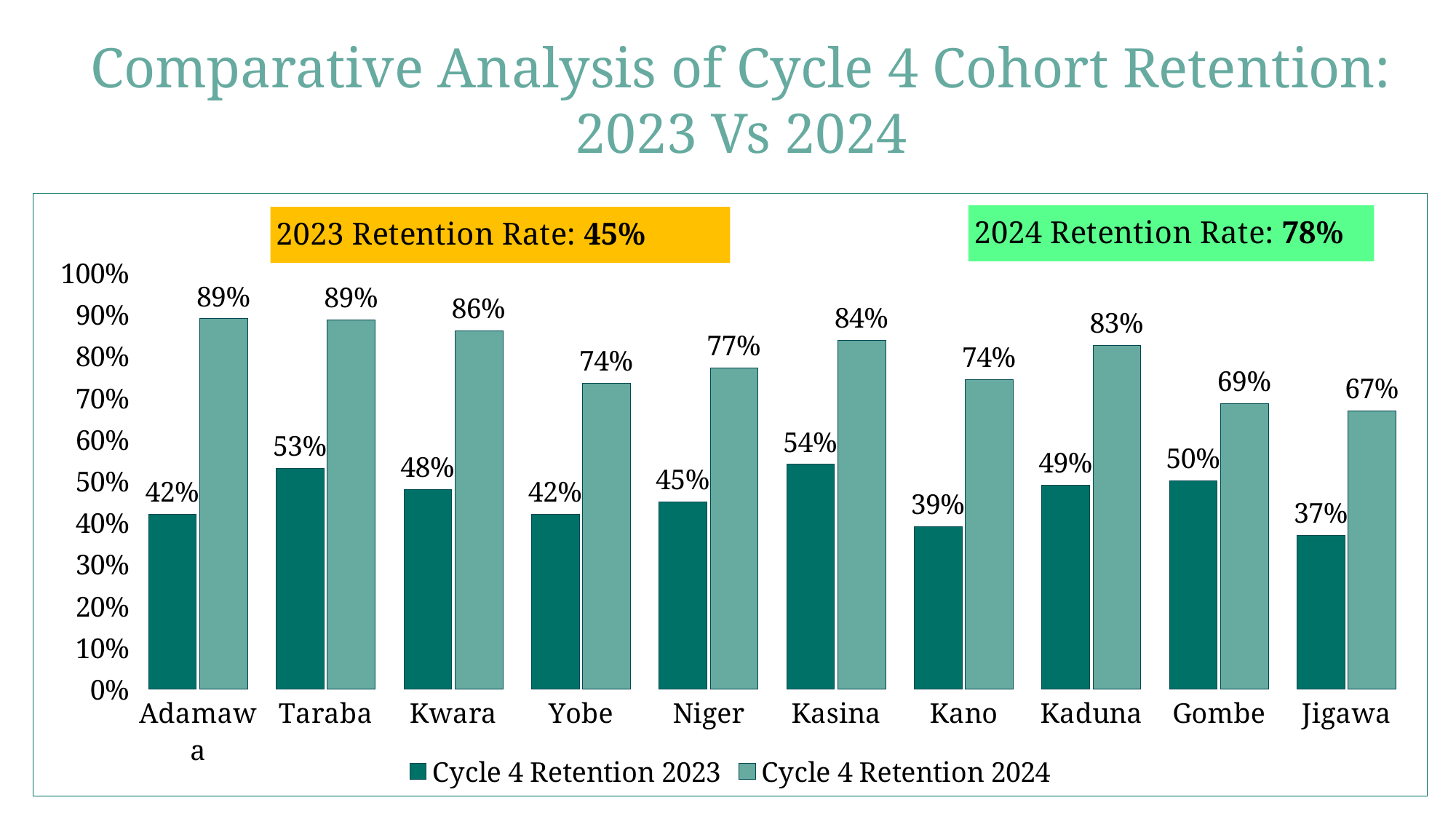
What is the difference between the 2024 and 2023 Cycle 4 Retention values for Adamawa? 47% Which state has the lowest Cycle 4 Retention 2024 value? Jigawa What kind of chart is shown on the slide? Bar chart What is the Cycle 4 Retention 2024 value for Kaduna? 83% Which is larger, the Cycle 4 Retention 2023 value for Gombe or for Kano? Gombe Which state has the highest Cycle 4 Retention 2023 value? Kasina How many states are shown on the x axis? 10 What is the Cycle 4 Retention 2023 value for Kasina? 54% How many series does the legend list? 2 What is the Cycle 4 Retention 2023 value for Jigawa? 37% Which state has the lowest Cycle 4 Retention 2023 value? Jigawa What overall 2024 Retention Rate is stated in the green box on the slide? 78%